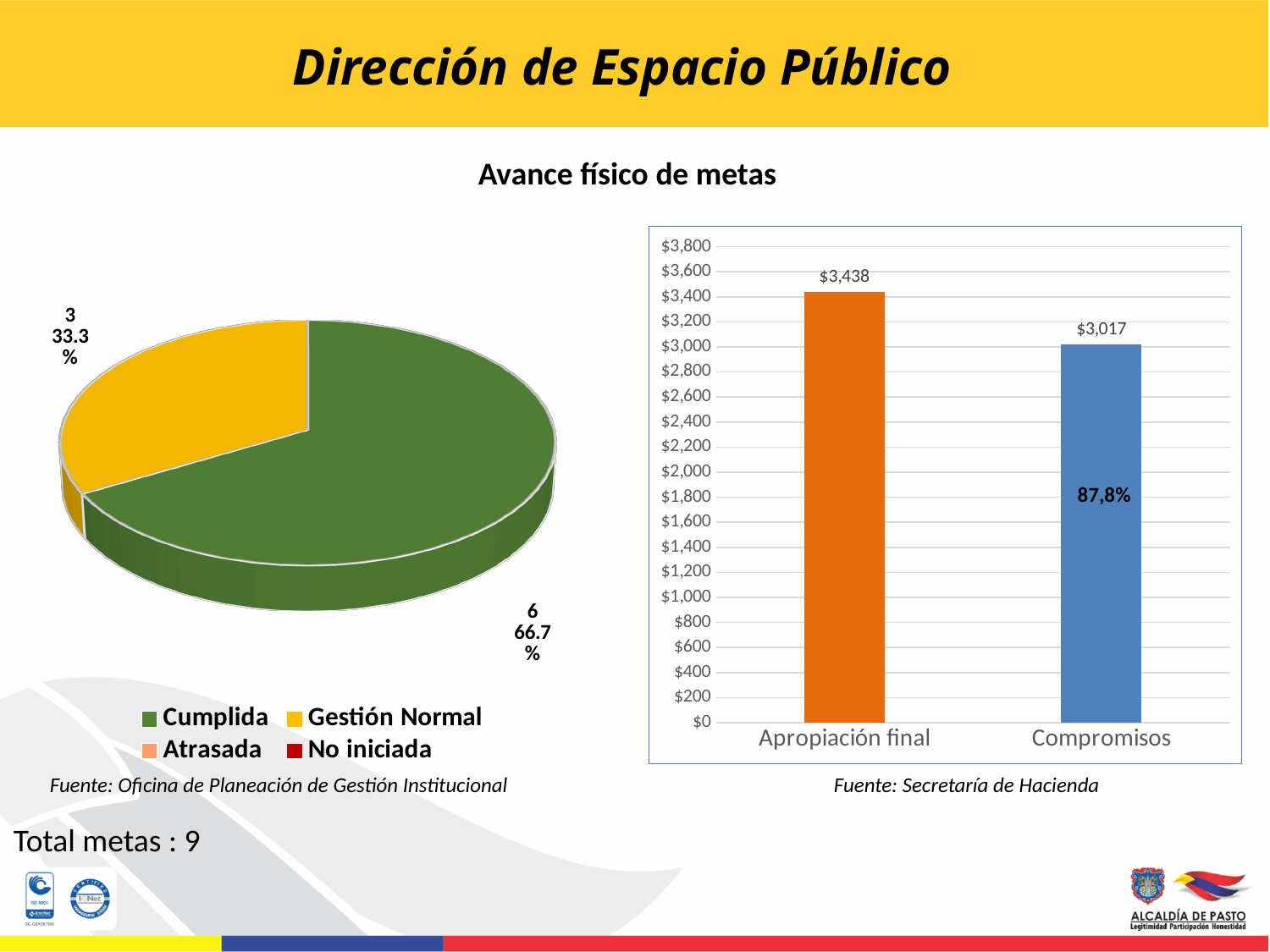
In the bar chart on the right, what is the value for Compromisos? $3,017 In the pie chart on the left, how many metas are labelled as Gestión Normal? 3 In the bar chart on the right, what is the difference between Apropiación final and Compromisos? $421 In the pie chart on the left, what colour is the Cumplida slice? Green In the bar chart on the right, what is the value for Apropiación final? $3,438 What kind of chart is shown on the right side of the slide? Bar chart In the pie chart on the left, what percentage share does the Cumplida slice have? 66.7% In the bar chart on the right, what percentage is printed on the Compromisos bar? 87,8% In the bar chart on the right, which is larger, Apropiación final or Compromisos? Apropiación final In the pie chart on the left, which category has the largest slice? Cumplida In the pie chart on the left, what percentage share does the Gestión Normal slice have? 33.3% How many entries does the legend of the pie chart on the left list? 4